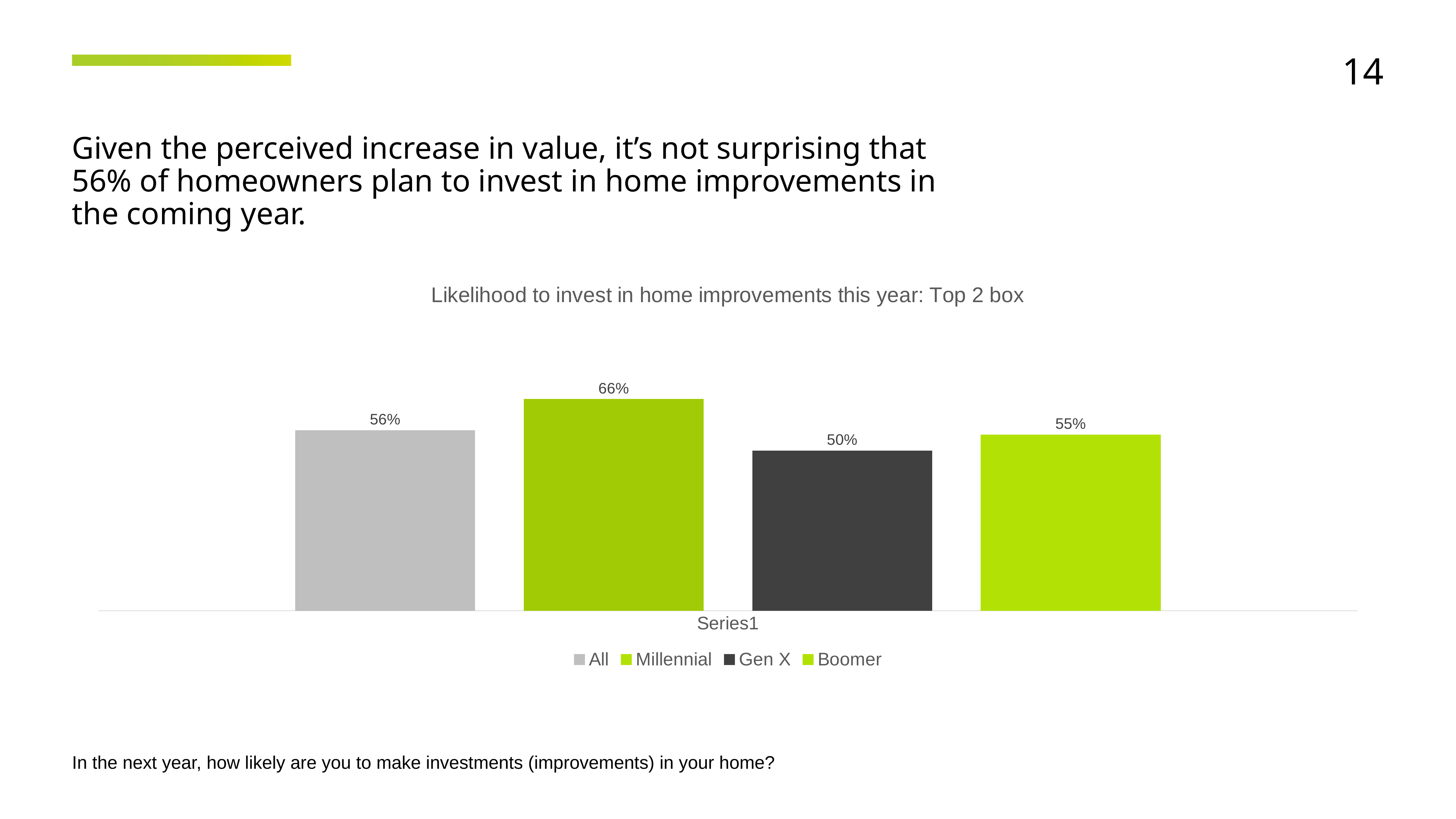
What kind of chart is shown on the slide? Bar chart What is the value for Boomer? 55% Which group has the highest likelihood to invest in home improvements this year? Millennial What is the value for All? 56% What is the value for Gen X? 50% What is the difference between the All value and the Boomer value? 1% What is the difference between the Millennial and Gen X values? 16% What is the title of the chart? Likelihood to invest in home improvements this year: Top 2 box What is the value for Millennial? 66% Which group has the lowest likelihood to invest in home improvements this year? Gen X Which is larger, the value for Millennial or the value for Boomer? Millennial How many series does the legend list? 4